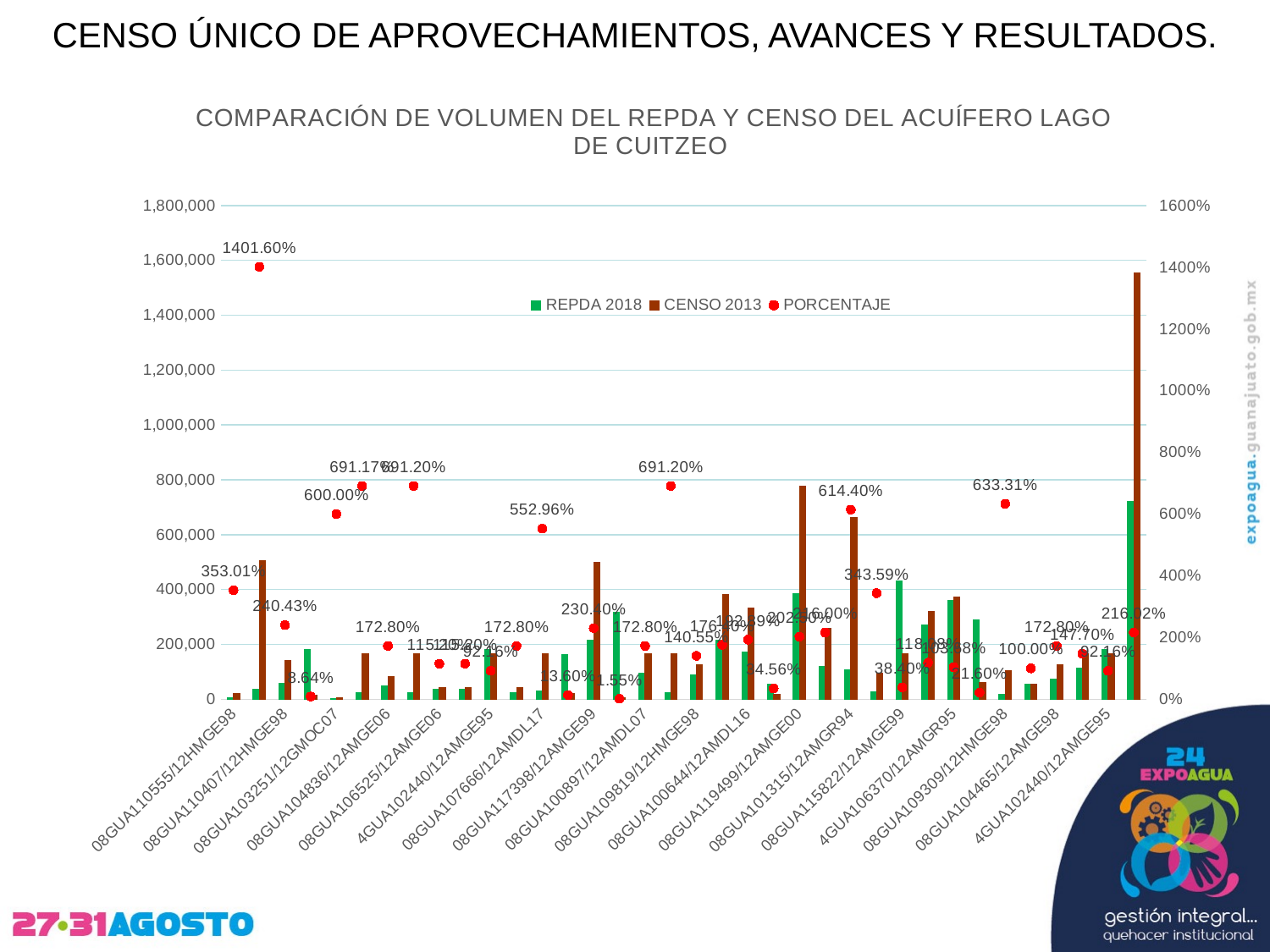
What is the highest PORCENTAJE value labelled on the chart? 1401.60% Which series has the tallest bar on the chart, REPDA 2018 or CENSO 2013? CENSO 2013 Is the tallest CENSO 2013 bar greater or less than 1,400,000? greater Is the tallest REPDA 2018 bar greater or less than 600,000? greater How many series does the chart legend list? 3 What is the lowest PORCENTAJE value labelled on the chart? 1.55% What is the difference between the highest labelled PORCENTAJE value (1401.60%) and the 633.31% label? 768.29% Which series is plotted as red dots rather than bars? PORCENTAJE What is the title of the chart? COMPARACIÓN DE VOLUMEN DEL REPDA Y CENSO DEL ACUÍFERO LAGO DE CUITZEO What is the maximum value shown on the right-hand percentage axis? 1600% Which labelled PORCENTAJE value is larger, 614.40% or 633.31%? 633.31% What kind of chart is this? bar chart with a percentage marker series